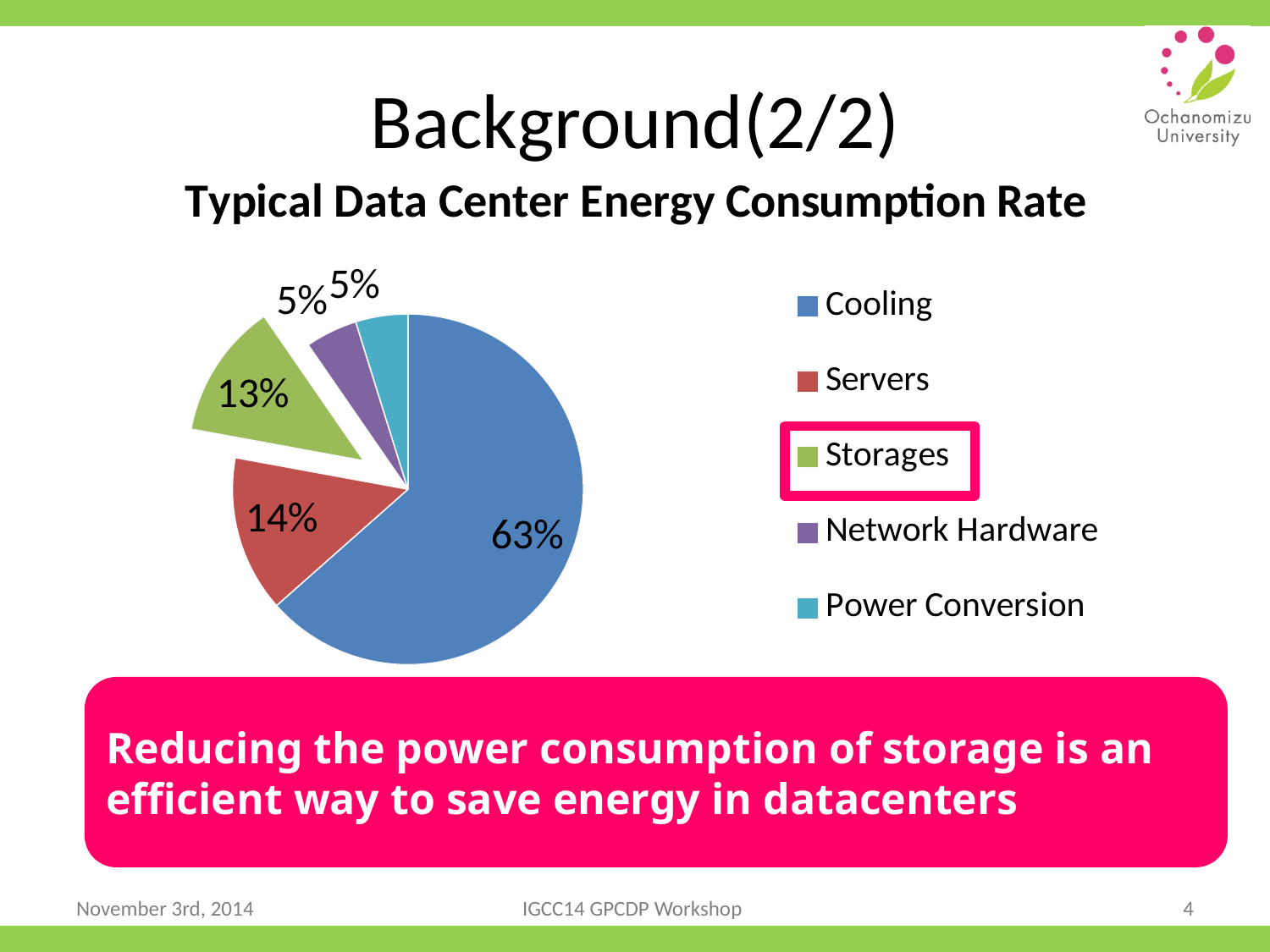
What percentage is shown for Servers? 14% What percentage is shown for Network Hardware? 5% How many entries does the legend list? 5 What is the difference in percentage points between Servers and Storages? 1 Which legend entry is highlighted with a pink box? Storages Which category has the largest slice of the pie? Cooling What percentage is shown for Storages? 13% What share of the pie does Cooling account for? 63% What kind of chart is shown on the slide? Pie chart Which is larger, the share for Servers or the share for Storages? Servers How many slices does the pie chart have? 5 What is the difference in percentage points between Cooling and Servers? 49